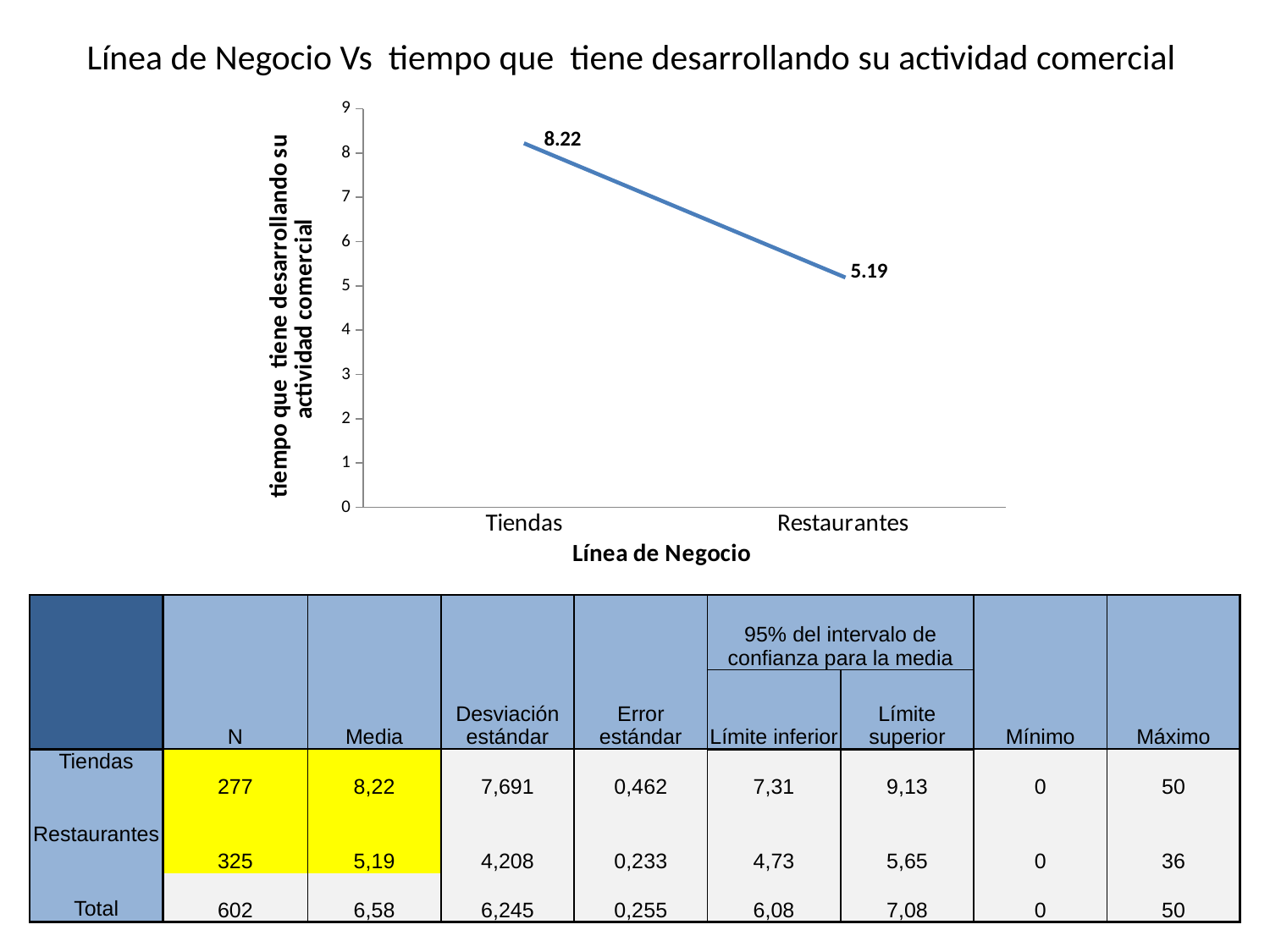
What is the value plotted for Tiendas? 8.22 What kind of chart is shown on the slide? line chart Which is larger, the value for Tiendas or the value for Restaurantes? Tiendas What is the difference between the values for Tiendas and Restaurantes? 3.03 Is the value for Restaurantes greater or less than 6? less Which category has the lowest value on the chart? Restaurantes Which category has the highest value on the chart? Tiendas How many categories are shown on the x axis of the chart? 2 What is the label of the x axis of the chart? Línea de Negocio Do the values rise or fall from Tiendas to Restaurantes? fall Is the value for Tiendas greater or less than 8? greater What is the value plotted for Restaurantes? 5.19